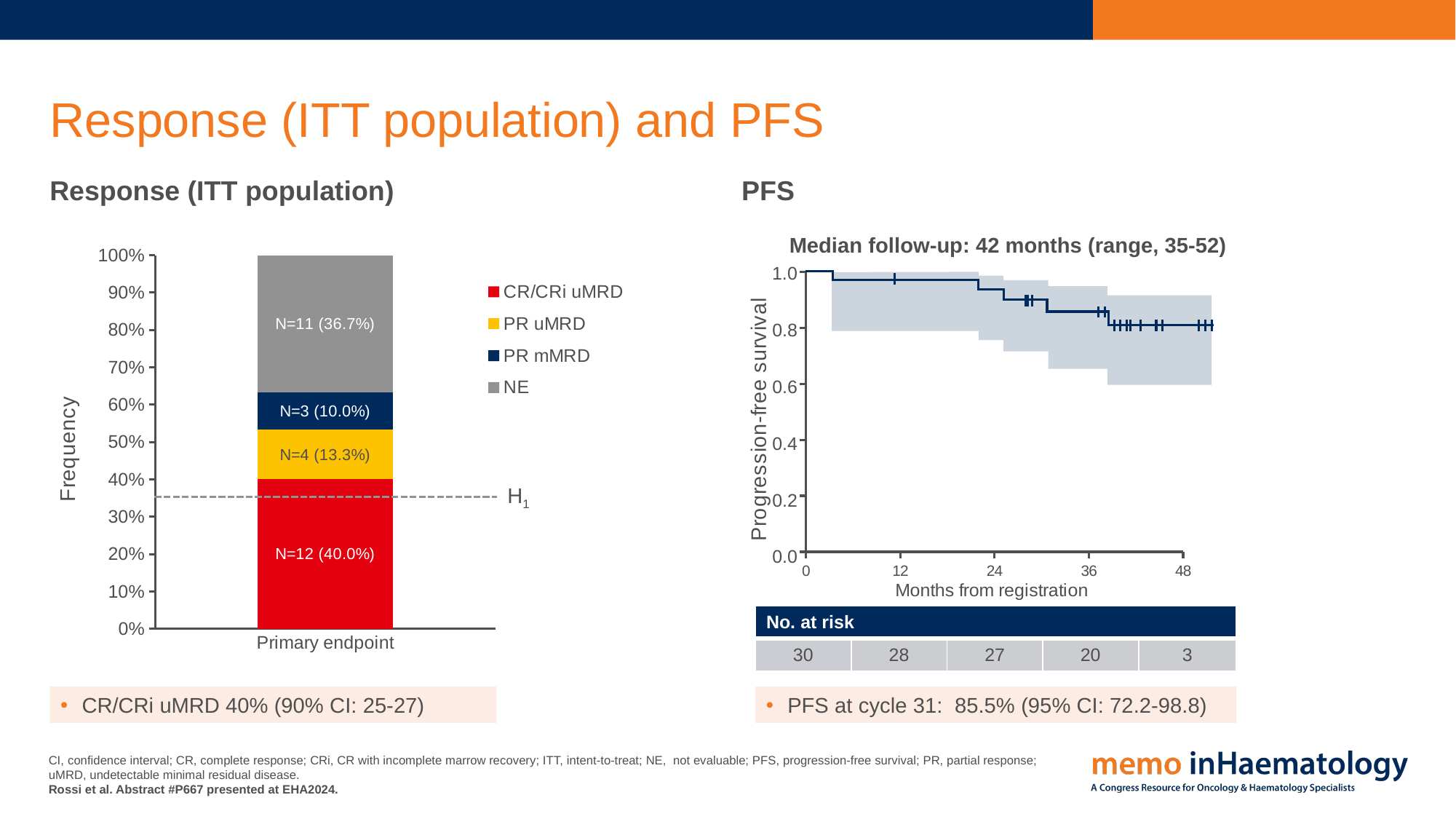
In the PFS chart, what is the number at risk at 36 months? 20 In the Response (ITT population) chart, what is the value shown for PR mMRD? N=3 (10.0%) What kind of chart is the Response (ITT population) chart? Stacked bar chart In the Response (ITT population) chart, which response category has the smallest share of the bar? PR mMRD In the Response (ITT population) chart, what is the value shown for PR uMRD? N=4 (13.3%) In the Response (ITT population) chart, what is the value shown for CR/CRi uMRD? N=12 (40.0%) In the Response (ITT population) chart, what is the value shown for NE? N=11 (36.7%) In the PFS chart, is the progression-free survival at 24 months greater or less than 0.8? greater In the Response (ITT population) chart, which response category has the largest share of the bar? CR/CRi uMRD In the Response (ITT population) chart, how many series does the legend list? 4 In the PFS chart, what is the number at risk at 0 months? 30 In the Response (ITT population) chart, what is the difference in number of patients between CR/CRi uMRD and NE? 1